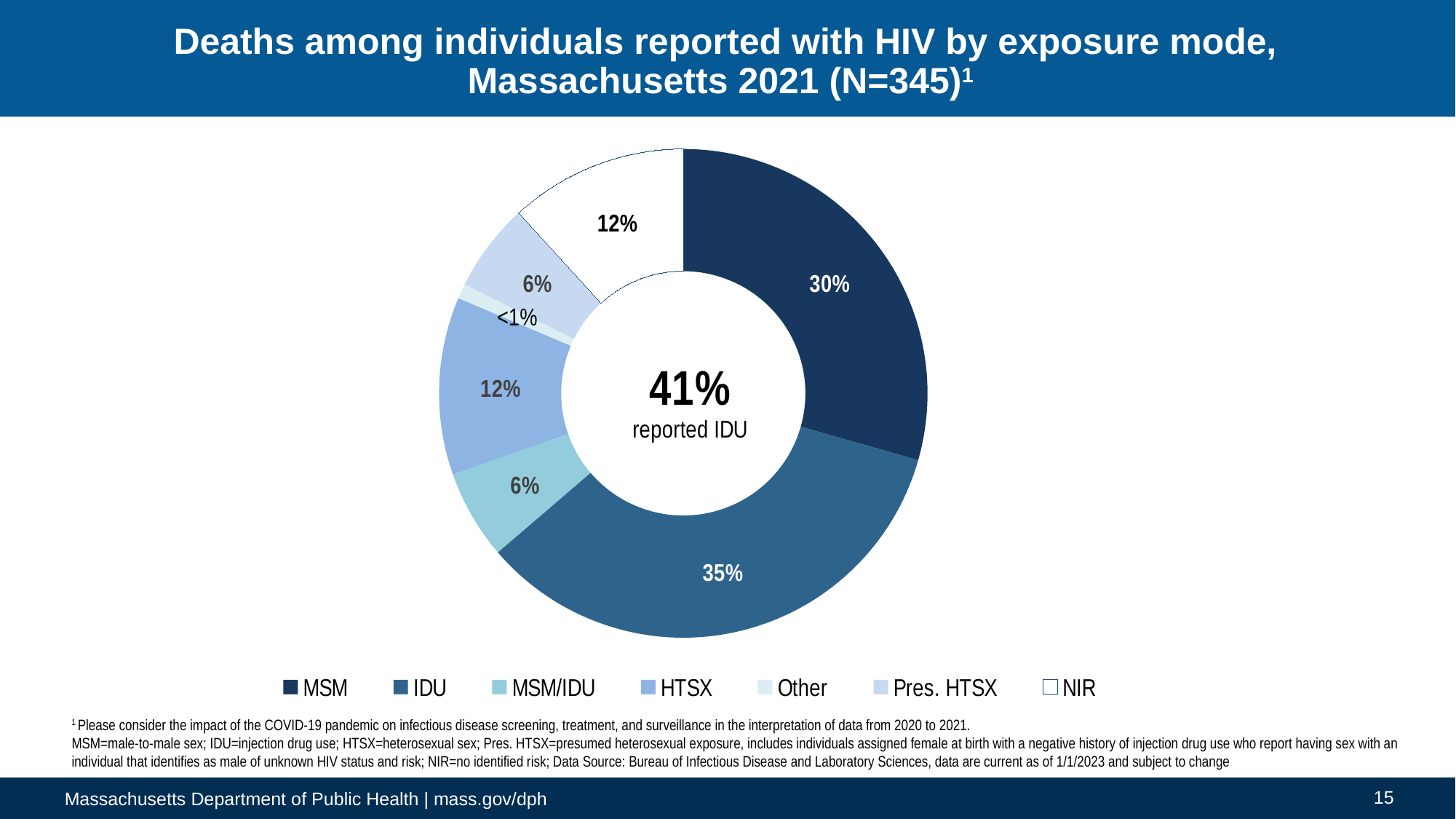
Which is larger, the share for NIR or the share for Pres. HTSX? NIR What percentage of deaths is attributed to the HTSX exposure mode? 12% Which exposure mode accounts for the largest share of deaths? IDU What percentage of deaths is attributed to the IDU exposure mode? 35% Which exposure mode accounts for the smallest share of deaths? Other What is the difference in percentage points between the IDU and MSM slices? 5 percentage points What kind of chart is shown on the slide? Donut (pie) chart What percentage is shown in the center of the donut chart as having reported IDU? 41% What percentage of deaths is attributed to the Other exposure mode? <1% What percentage of deaths is attributed to the MSM exposure mode? 30% What is the total N stated in the chart title? 345 How many exposure mode categories does the legend list? 7